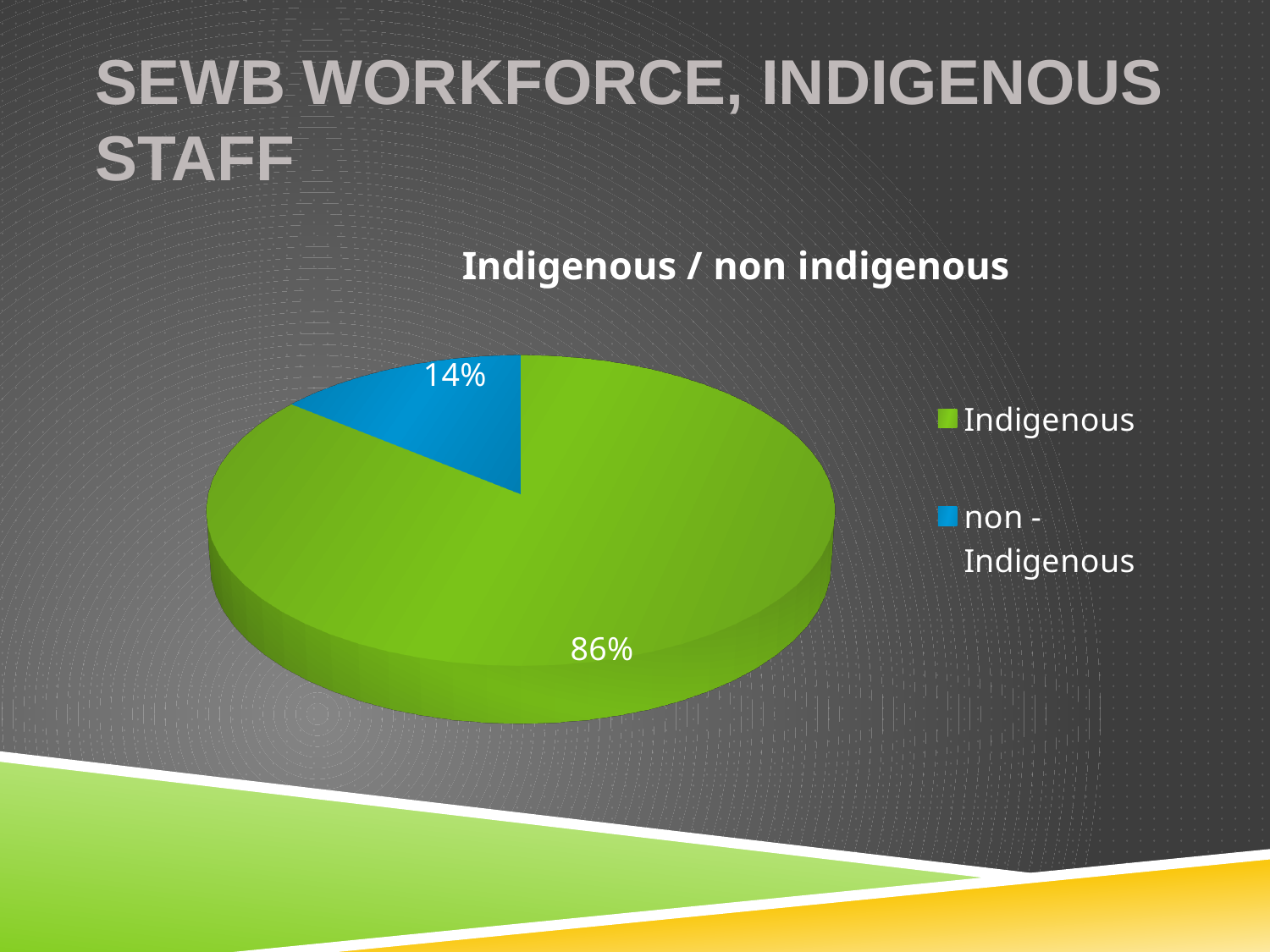
What share of the pie does the non - Indigenous slice represent? 14% Which category has the smallest slice of the pie? non - Indigenous How many entries does the legend list? 2 What colour is the Indigenous slice? Green What is the title of the chart? Indigenous / non indigenous What is the difference in percentage points between the Indigenous and non - Indigenous slices? 72 Which category has the largest slice of the pie? Indigenous How many slices does the pie chart have? 2 Which is larger, the Indigenous slice or the non - Indigenous slice? Indigenous What share of the pie does the Indigenous slice represent? 86% What kind of chart is shown on the slide? Pie chart